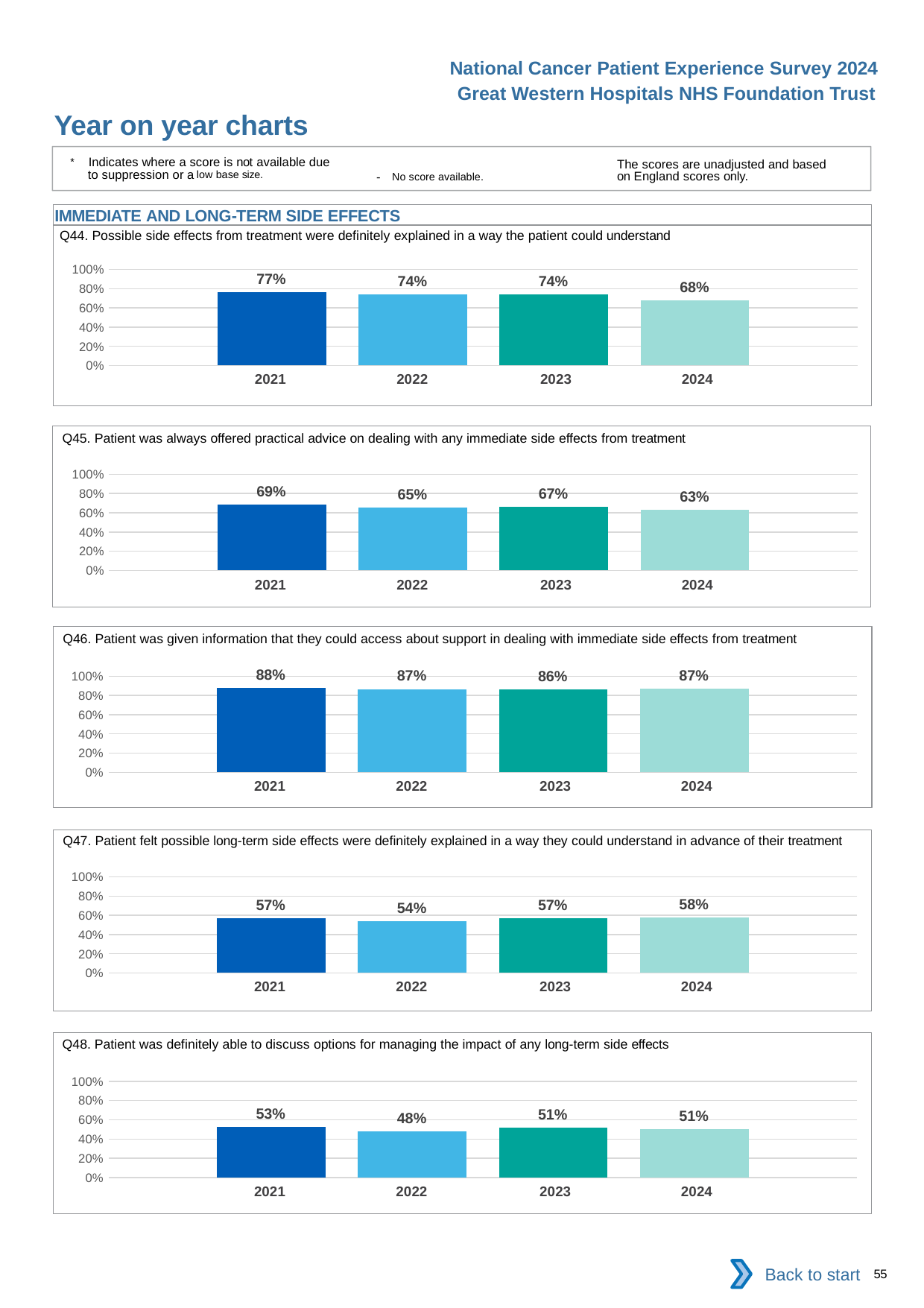
In the Q47 chart, which is larger, the value for 2022 or the value for 2024? 2024 In the Q44 chart, which year has the lowest value? 2024 In the Q46 chart, what is the value for 2023? 86% What kind of chart is the Q44 chart? Bar chart In the Q48 chart, what is the difference between the 2021 and 2022 values? 5 percentage points In the Q48 chart, which year has the lowest value? 2022 In the Q44 chart, do the values rise or fall from 2021 to 2024? Fall In the Q45 chart, what is the difference between the 2021 and 2024 values? 6 percentage points In the Q47 chart, what is the value for 2024? 58% In the Q44 chart, what is the value for 2021? 77% In the Q46 chart, how many years are plotted? 4 In the Q45 chart, which year has the highest value? 2021